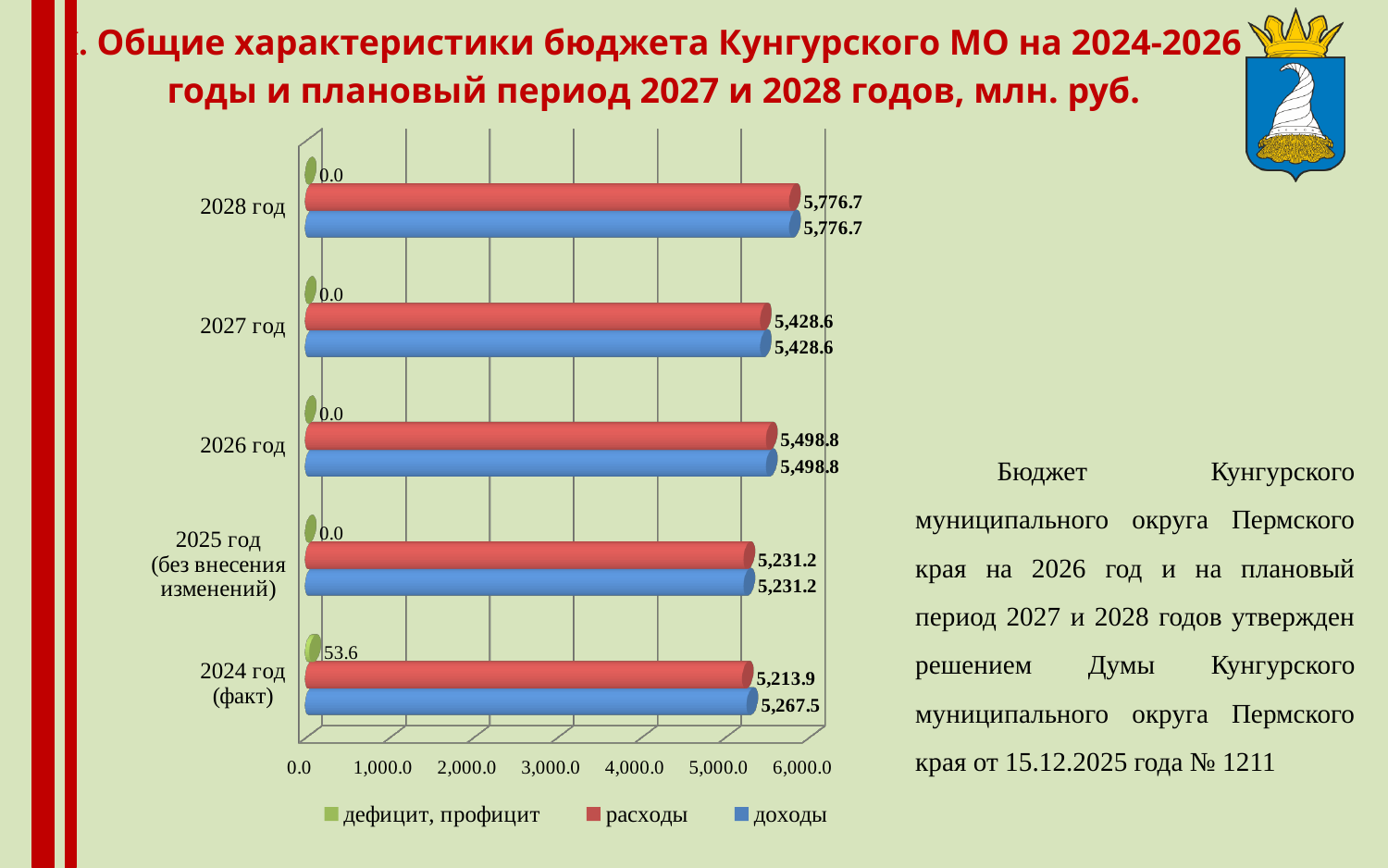
What is the value of доходы for 2028 год? 5,776.7 How many series does the legend list? 3 What is the value of дефицит, профицит for 2024 год (факт)? 53.6 Which series is shown in blue in the legend? доходы Which year has the highest value of доходы? 2028 год What is the value of расходы for 2024 год (факт)? 5,213.9 What is the value of расходы for 2026 год? 5,498.8 Which year has the lowest value of расходы? 2024 год (факт) What is the difference between доходы and расходы for 2024 год (факт)? 53.6 What kind of chart is shown on the slide? bar chart How many year categories are shown on the chart? 5 Which is larger, расходы for 2027 год or расходы for 2026 год? 2026 год